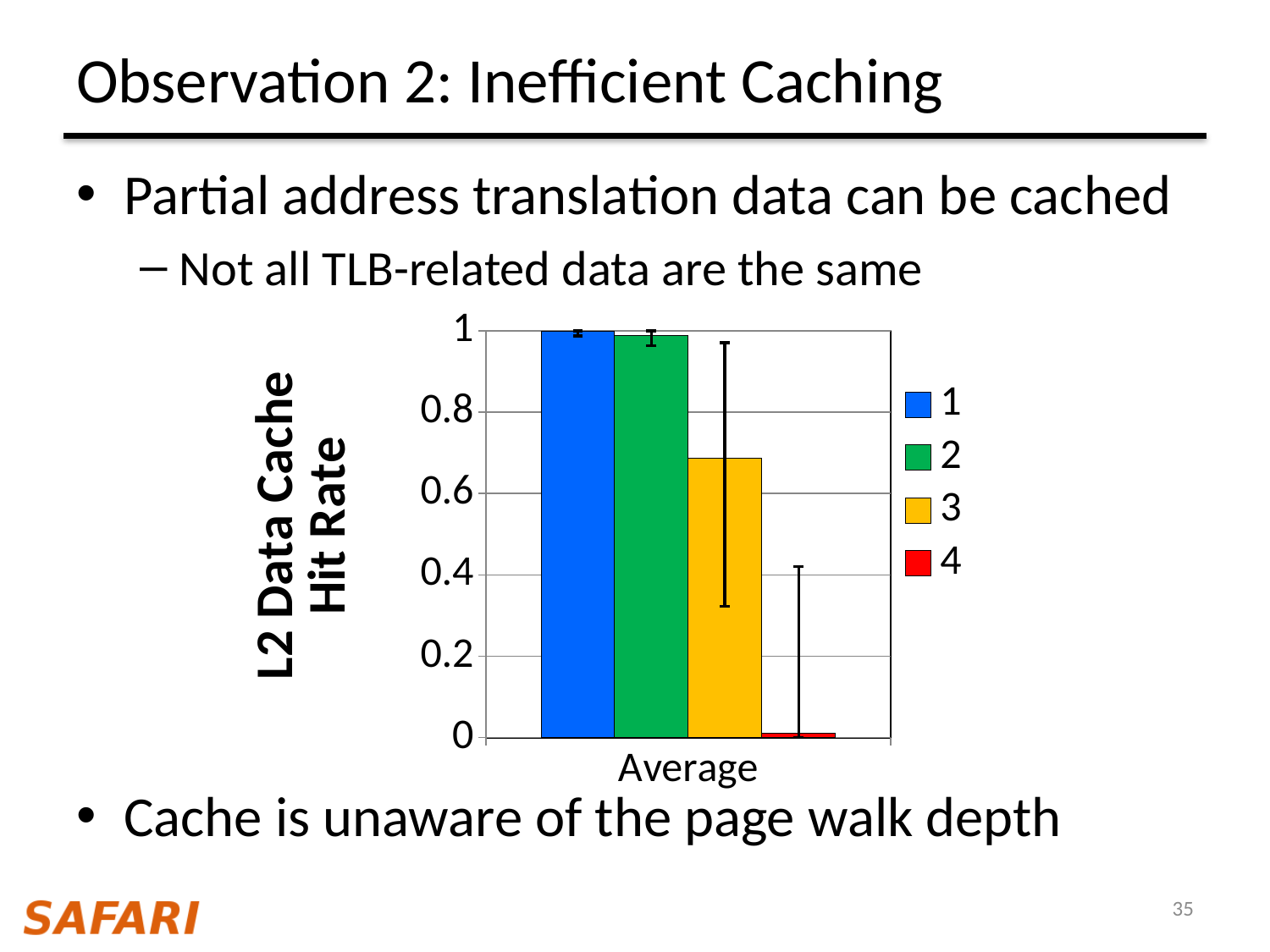
Which has a higher L2 Data Cache Hit Rate, series 3 or series 4? 3 What is the title of the y axis? L2 Data Cache Hit Rate Which series has the lowest L2 Data Cache Hit Rate? 4 Which has a higher L2 Data Cache Hit Rate, series 1 or series 3? 1 What is the label of the category on the x axis? Average How many series does the legend list? 4 How many categories are shown on the x axis? 1 Is the L2 Data Cache Hit Rate for series 4 greater or less than 0.2? less Is the L2 Data Cache Hit Rate for series 1 greater or less than 0.8? greater Is the L2 Data Cache Hit Rate for series 3 greater or less than 0.8? less What kind of chart is shown on the slide? bar chart